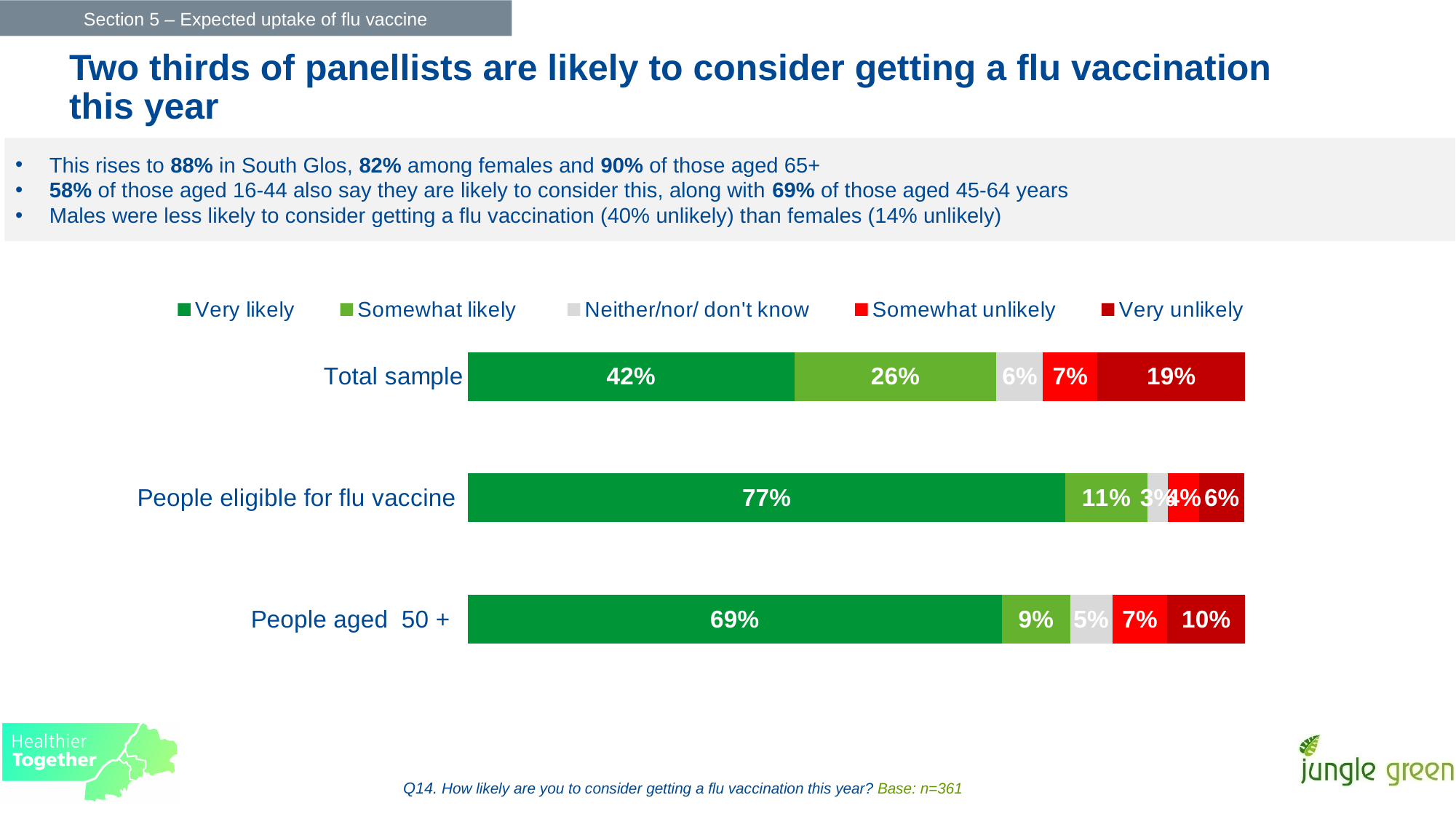
Which category has the lowest 'Very likely' value? Total sample What is the 'Very likely' value for the Total sample? 42% Which category has the highest 'Very likely' value? People eligible for flu vaccine How many series does the legend list? 5 How many categories (bars) are plotted in the chart? 3 What is the 'Very likely' value for People eligible for flu vaccine? 77% What is the 'Somewhat likely' value for the Total sample? 26% What is the 'Very unlikely' value for People aged 50 +? 10% Which is larger: the 'Somewhat likely' value for the Total sample or for People aged 50 +? Total sample Which legend entry is shown in light grey? Neither/nor/ don't know What is the difference between the 'Very unlikely' values for the Total sample and People aged 50 +? 9 percentage points What kind of chart is shown on the slide? Stacked bar chart